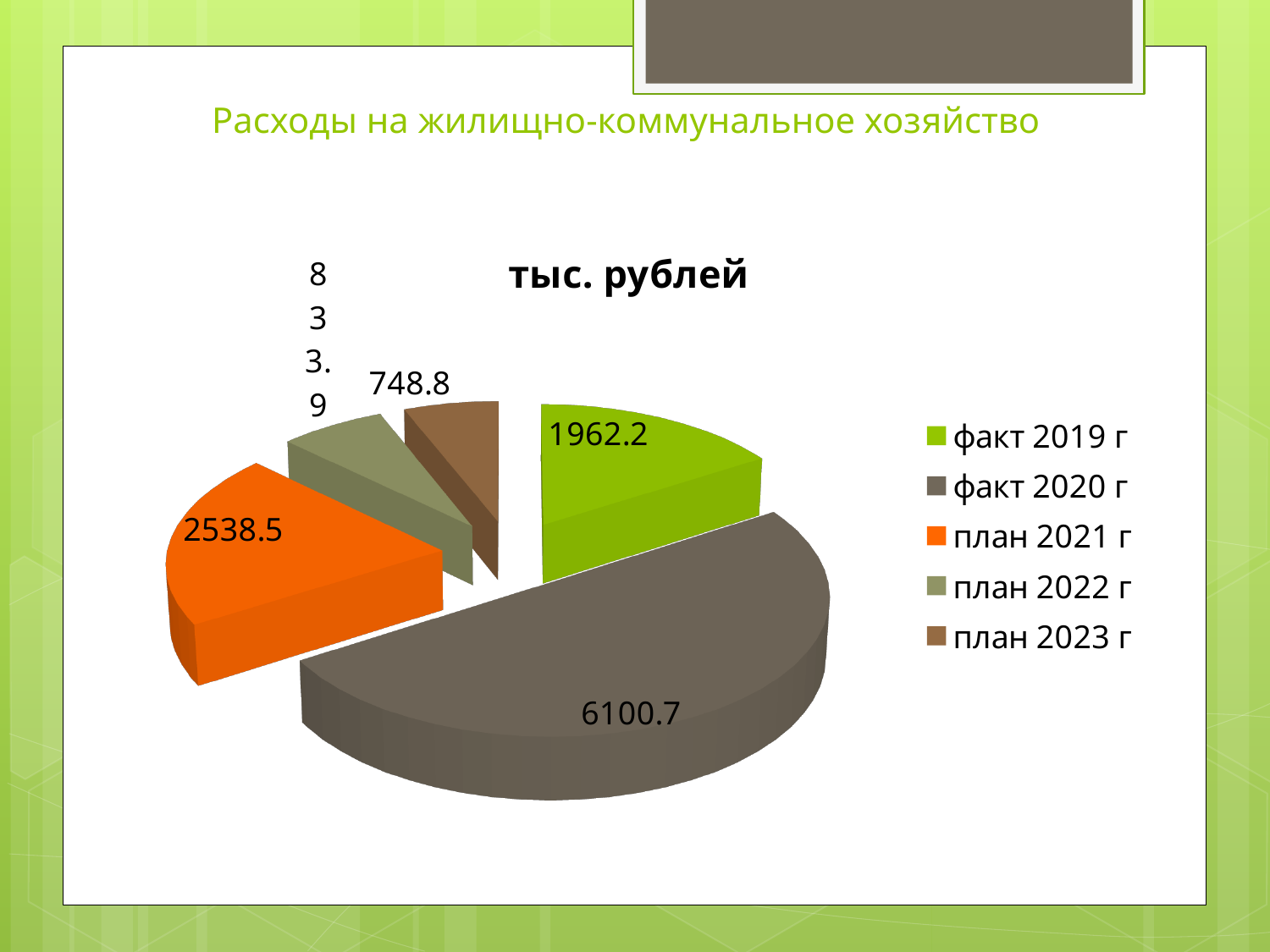
Which is larger, the value for план 2021 г or the value for факт 2019 г? план 2021 г What is the difference between the values for факт 2020 г and факт 2019 г? 4138.5 What kind of chart is shown on the slide? pie chart What is the value for факт 2020 г? 6100.7 What is the difference between the values for план 2021 г and факт 2019 г? 576.3 Which category has the smallest slice of the pie? план 2023 г How many categories does the legend list? 5 Which category has the largest slice of the pie? факт 2020 г What is the value for план 2023 г? 748.8 What is the value for факт 2019 г? 1962.2 What is the title of the chart? тыс. рублей What is the value for план 2021 г? 2538.5